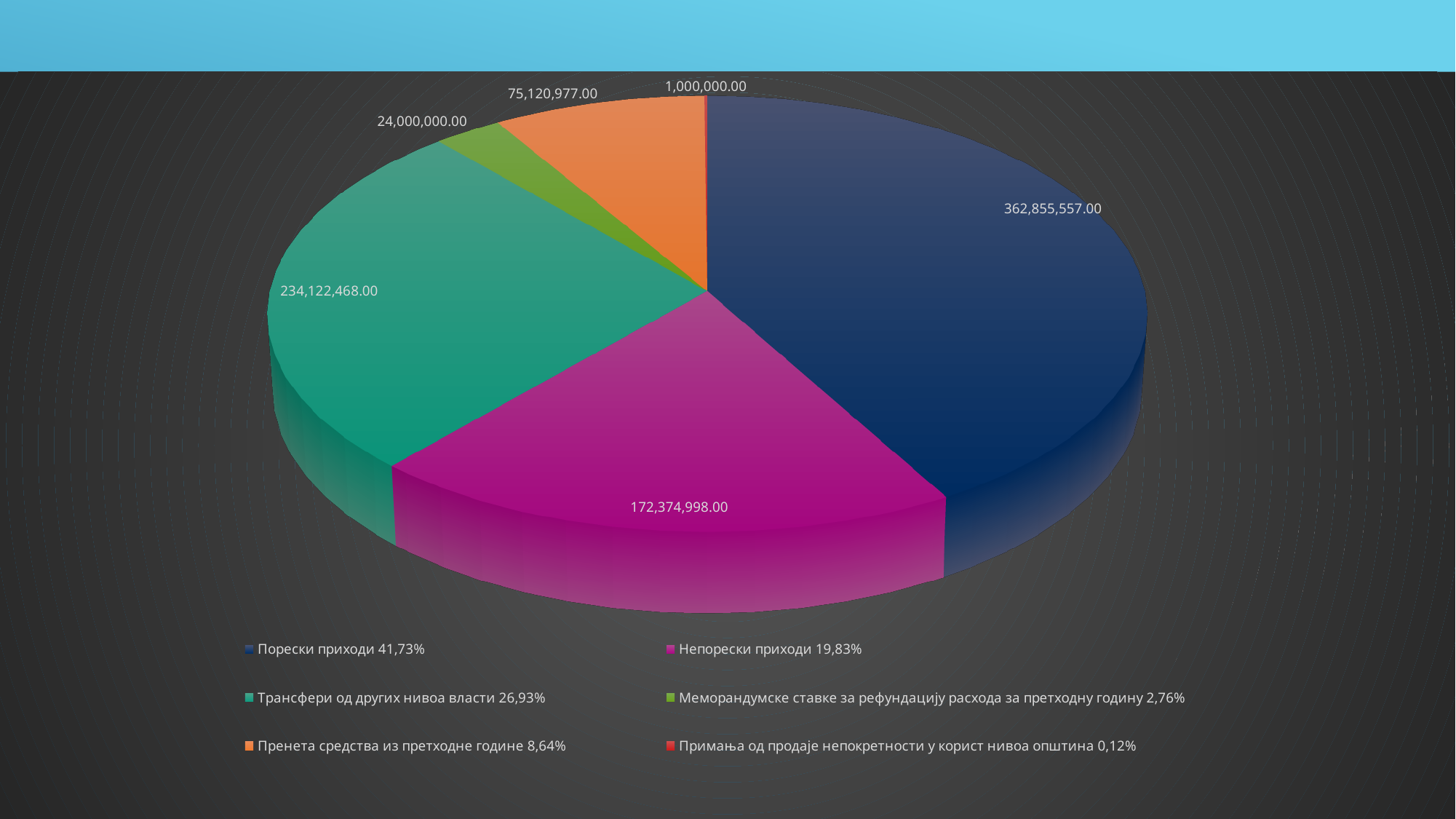
How many slices does the pie chart have? 6 What is the value of the Порески приходи slice? 362,855,557.00 Which category has the smallest slice of the pie? Примања од продаје непокретности у корист нивоа општина What share of the pie does Непорески приходи represent, according to the legend? 19,83% What is the value of the Примања од продаје непокретности у корист нивоа општина slice? 1,000,000.00 Which is larger, Непорески приходи or Трансфери од других нивоа власти? Трансфери од других нивоа власти What is the value of the Трансфери од других нивоа власти slice? 234,122,468.00 Which category has the largest slice of the pie? Порески приходи What kind of chart is shown on the slide? Pie chart What is the difference between the Порески приходи value and the Трансфери од других нивоа власти value? 128,733,089.00 What is the value of the Пренета средства из претходне године slice? 75,120,977.00 What colour is the Меморандумске ставке за рефундацију расхода за претходну годину slice? Green